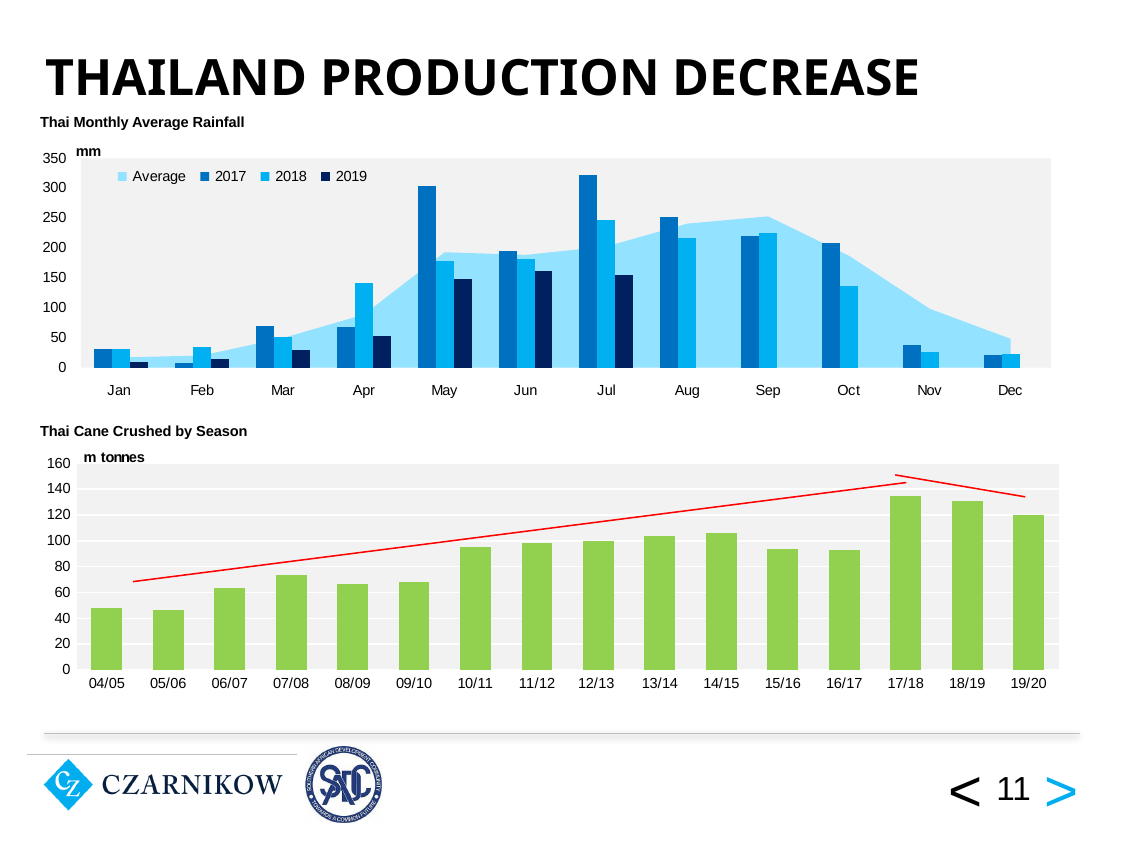
In the Thai Cane Crushed by Season chart, which is larger, the value for 10/11 or the value for 09/10? 10/11 What kind of chart is Thai Cane Crushed by Season? bar chart In the Thai Monthly Average Rainfall chart, which is larger for Oct, the 2017 value or the 2018 value? 2017 In the Thai Monthly Average Rainfall chart, is the 2017 value for Nov greater or less than 50? less In the Thai Monthly Average Rainfall chart, how many series does the legend list? 4 In the Thai Monthly Average Rainfall chart, what unit is shown on the y axis? mm In the Thai Cane Crushed by Season chart, is the value for 17/18 greater or less than 120? greater In the Thai Monthly Average Rainfall chart, is the 2017 value for May greater or less than 250? greater In the Thai Cane Crushed by Season chart, how many seasons are shown? 16 In the Thai Monthly Average Rainfall chart, how many months are shown on the x axis? 12